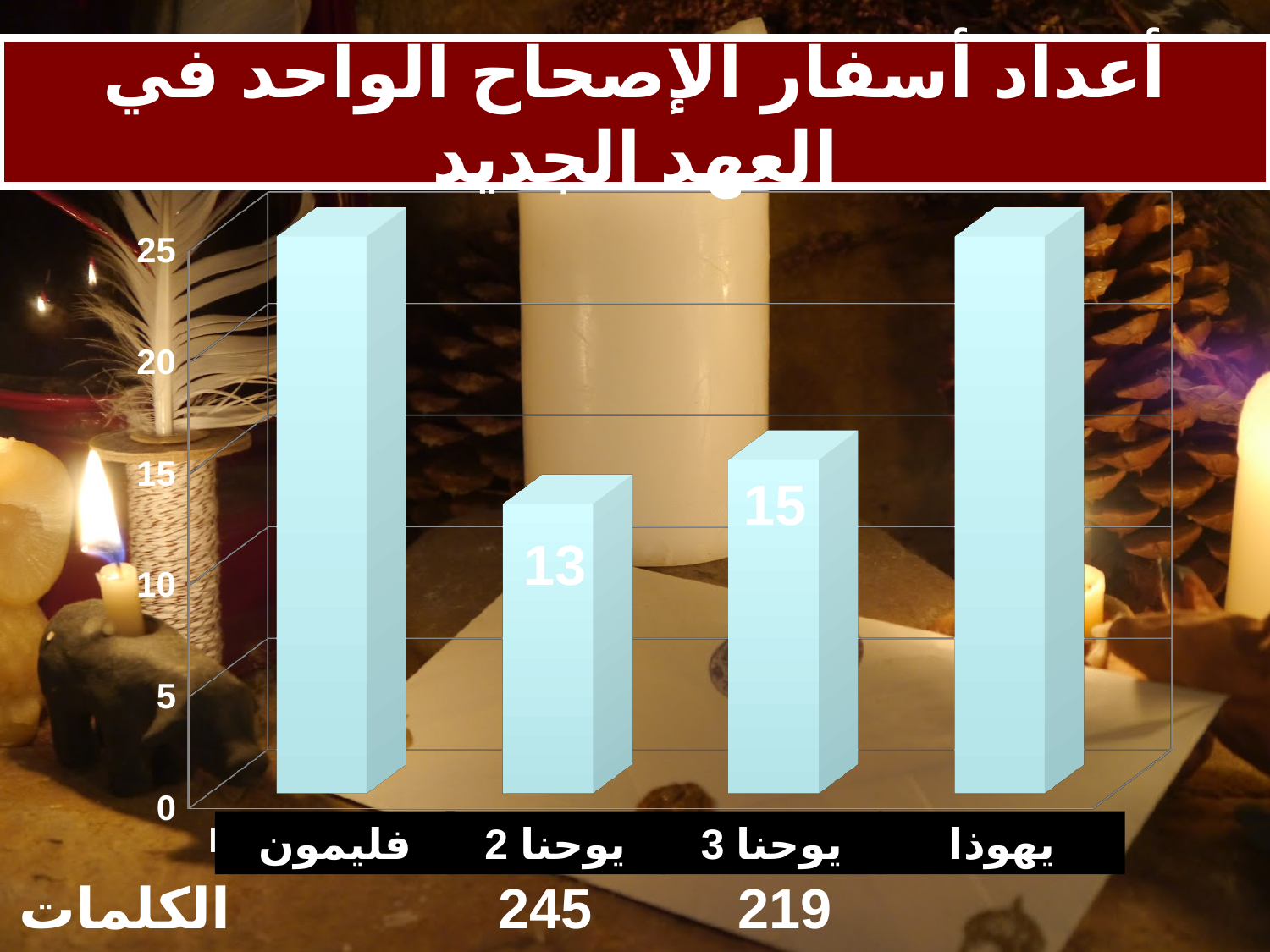
What kind of chart is shown on the slide? bar chart What is the value shown for يوحنا 2? 13 Is the value for فليمون greater or less than 20? greater What is the highest value labelled on the vertical axis? 25 How many categories are shown on the chart? 4 Which has the larger value, يوحنا 2 or يوحنا 3? يوحنا 3 Which category has the lowest value? يوحنا 2 What is the title of the chart? أعداد أسفار الإصحاح الواحد في العهد الجديد What is the difference between the values for يوحنا 3 and يوحنا 2? 2 Which has the larger value, فليمون or يوحنا 3? فليمون Is the value for يهوذا greater or less than 20? greater What is the value shown for يوحنا 3? 15